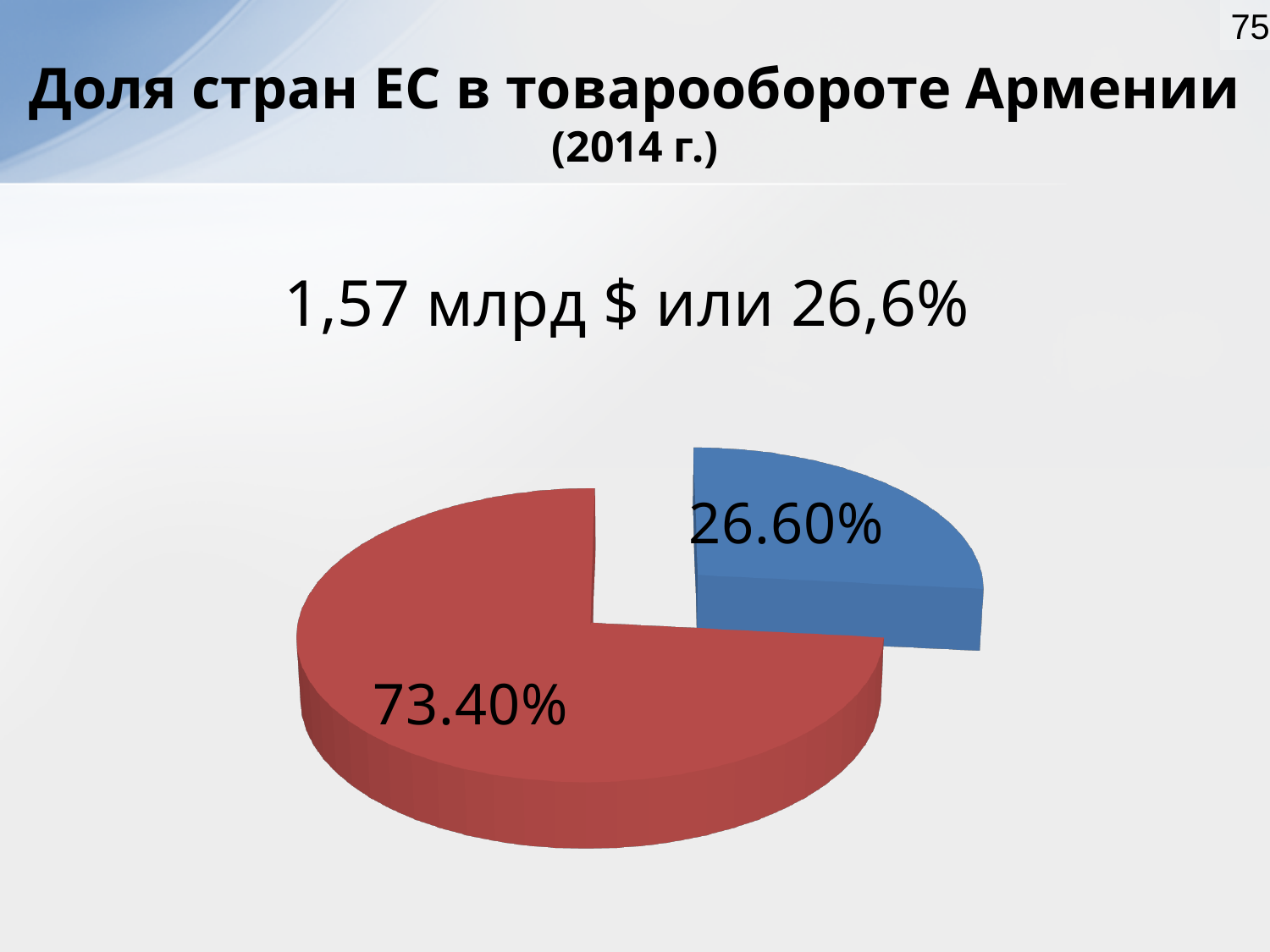
What is the difference in percentage points between the red slice and the blue slice? 46.80 Which slice of the pie chart is the largest? the red slice (73.40%) Which slice of the pie chart is the smallest? the blue slice (26.60%) What percentage is shown on the blue slice of the pie chart? 26.60% What is the title of the slide containing the pie chart? Доля стран ЕС в товарообороте Армении (2014 г.) Which slice is larger, the blue one or the red one? the red one What amount in dollars is stated above the pie chart as corresponding to 26,6%? 1,57 млрд $ What kind of chart is shown on the slide? pie chart What share of the pie does the blue slice represent? 26.60% What percentage is shown on the red slice of the pie chart? 73.40% Is the value of the blue slice greater or less than 50%? less How many slices does the pie chart have? 2